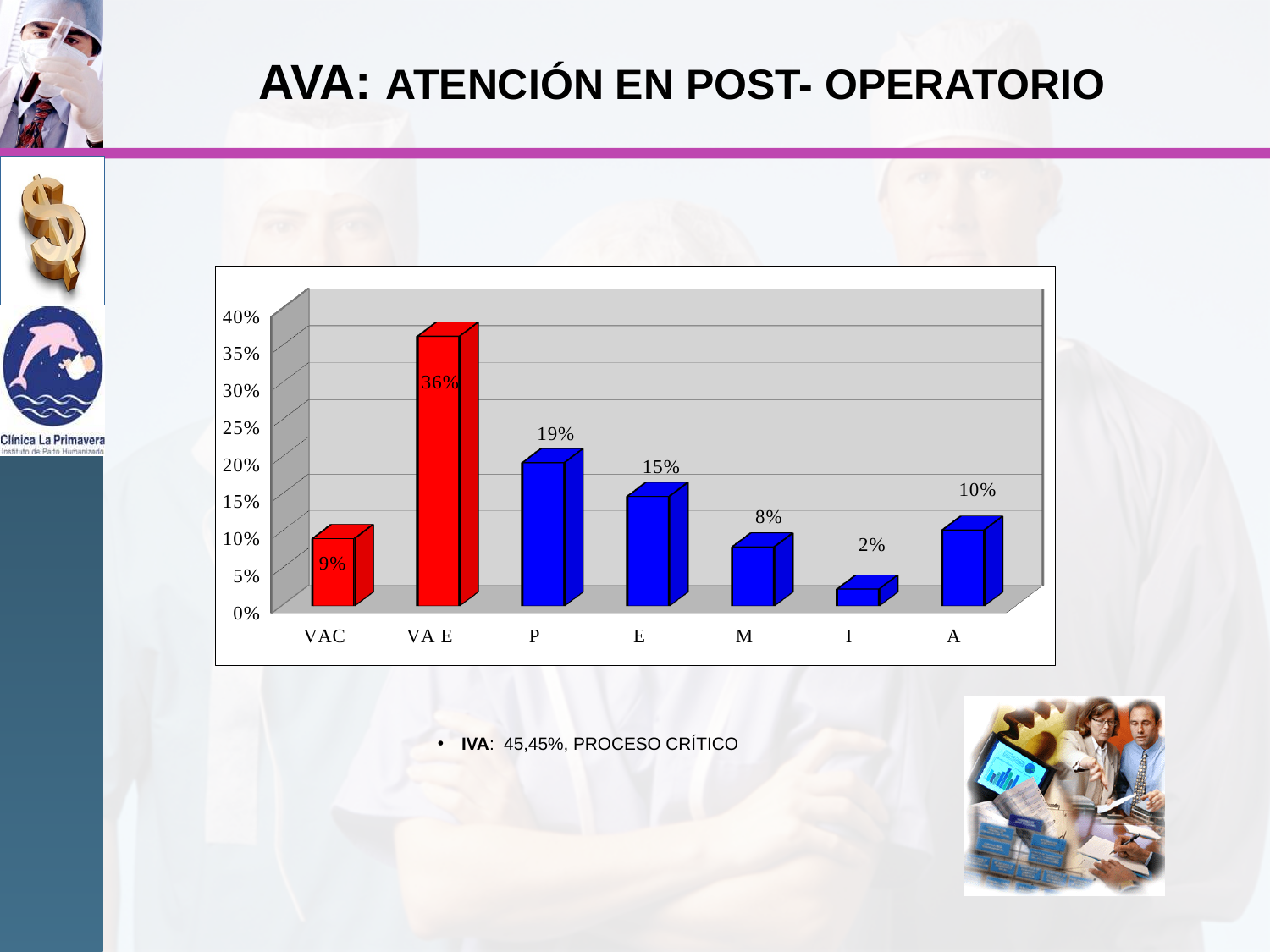
What is the value for A? 10% What kind of chart is shown on the slide? bar chart What is the value for P? 19% What is the difference between the values for E and M? 7% Which is larger, the value for VAC or the value for A? A Which category has the lowest value? I Which bars are coloured red? VAC and VA E What is the value for VA E? 36% How many categories are shown on the x axis? 7 Which category has the highest value? VA E What is the difference between the values for VA E and P? 17% What is the value for I? 2%